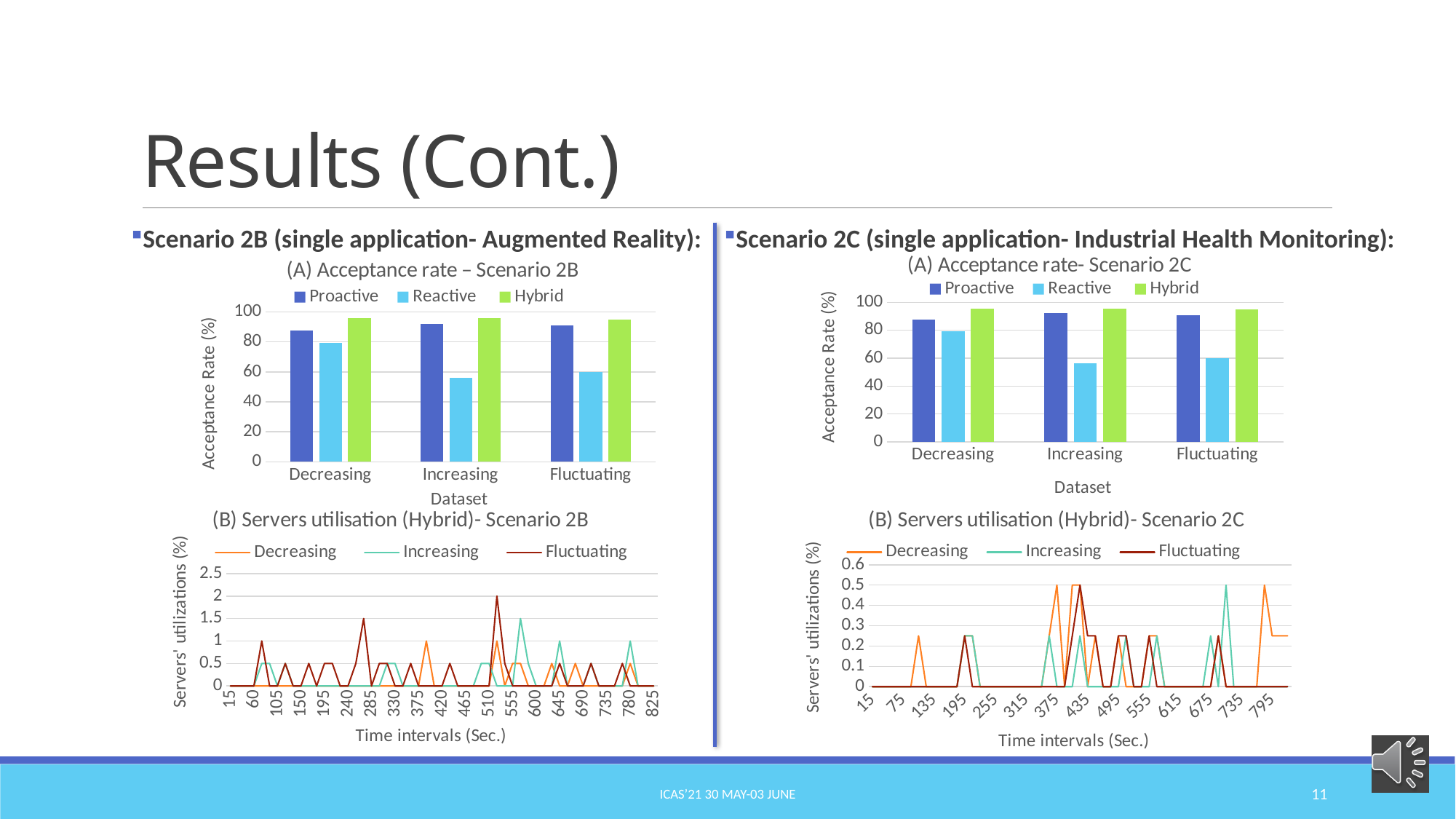
In the chart titled "(A) Acceptance rate – Scenario 2B", what kind of chart is shown? bar chart In the chart titled "(B) Servers utilisation (Hybrid)- Scenario 2C", what is the label of the x axis? Time intervals (Sec.) In the chart titled "(A) Acceptance rate – Scenario 2B", how many series does the legend list? 3 In the chart titled "(A) Acceptance rate – Scenario 2B", how many dataset categories are shown on the x axis? 3 In the chart titled "(A) Acceptance rate- Scenario 2C", which series has the highest acceptance rate for the Decreasing dataset? Hybrid In the chart titled "(B) Servers utilisation (Hybrid)- Scenario 2C", how many series does the legend list? 3 In the chart titled "(A) Acceptance rate – Scenario 2B", is the Reactive value for Increasing greater or less than 60? less In the chart titled "(A) Acceptance rate – Scenario 2B", which series has the lowest acceptance rate for the Fluctuating dataset? Reactive In the chart titled "(B) Servers utilisation (Hybrid)- Scenario 2B", which series reaches the highest peak value? Fluctuating In the chart titled "(A) Acceptance rate- Scenario 2C", which is larger for the Increasing dataset: Proactive or Reactive? Proactive In the chart titled "(A) Acceptance rate- Scenario 2C", is the Reactive value for Decreasing greater or less than 60? greater In the chart titled "(B) Servers utilisation (Hybrid)- Scenario 2B", what kind of chart is shown? line chart